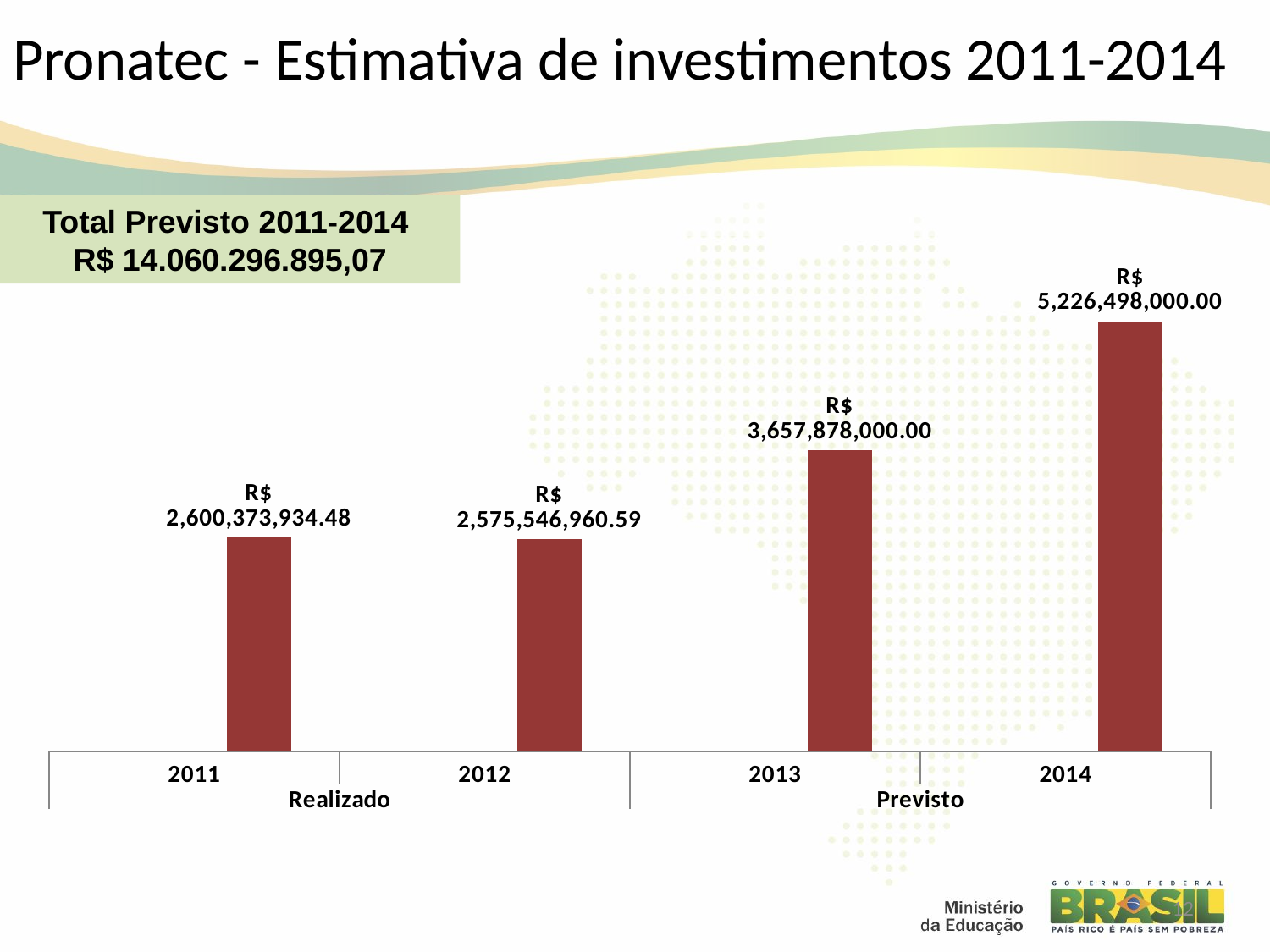
How many years are shown in the chart? 4 Do the values rise or fall from 2012 to 2014? rise What is the value for 2011? R$ 2,600,373,934.48 What is the difference between the values for 2014 and 2013? R$ 1,568,620,000.00 What is the value for 2014? R$ 5,226,498,000.00 What is the value for 2012? R$ 2,575,546,960.59 Which years are grouped under 'Previsto' on the x axis? 2013 and 2014 Which is larger, the value for 2013 or the value for 2012? 2013 What is the value for 2013? R$ 3,657,878,000.00 Which year has the highest value? 2014 Which year has the lowest value? 2012 What kind of chart is shown on the slide? bar chart